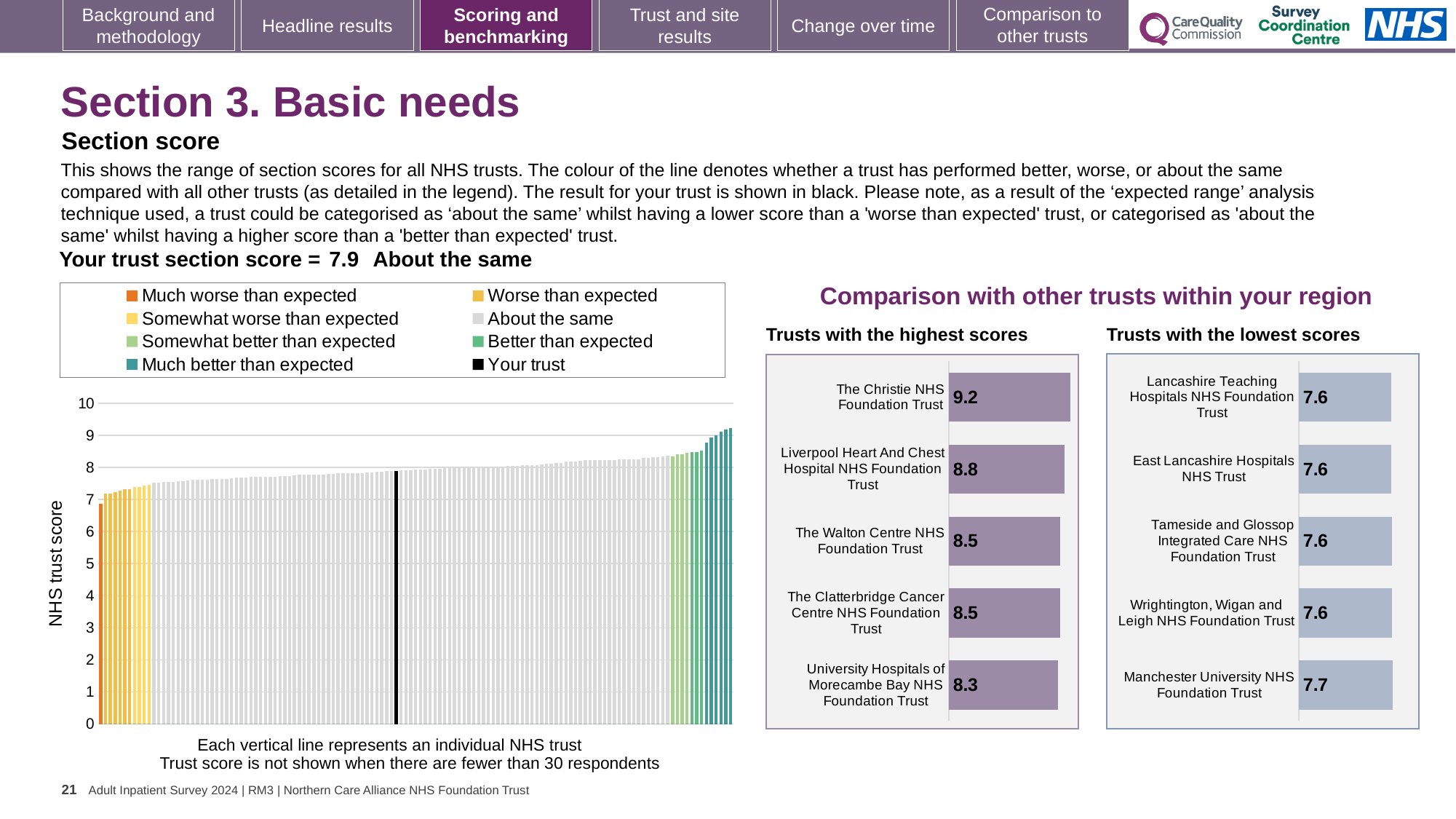
In the 'Trusts with the highest scores' chart, which trust has the lowest score shown? University Hospitals of Morecambe Bay NHS Foundation Trust How many trusts are listed in the 'Trusts with the highest scores' chart? 5 How many entries does the legend of the 'NHS trust score' chart on the left list? 8 In the 'NHS trust score' chart on the left, is the value of the tallest bar greater or less than 9? greater In the 'Trusts with the lowest scores' chart, what is the difference between the scores of Manchester University NHS Foundation Trust and East Lancashire Hospitals NHS Trust? 0.1 In the 'Trusts with the highest scores' chart, what is the difference between the scores of The Christie NHS Foundation Trust and Liverpool Heart And Chest Hospital NHS Foundation Trust? 0.4 In the 'Trusts with the lowest scores' chart, which trust has the highest score? Manchester University NHS Foundation Trust What kind of chart is the 'NHS trust score' chart on the left of the slide? Bar chart In the 'Trusts with the highest scores' chart, which has the higher score: Liverpool Heart And Chest Hospital NHS Foundation Trust or The Walton Centre NHS Foundation Trust? Liverpool Heart And Chest Hospital NHS Foundation Trust In the 'NHS trust score' chart on the left, do the values rise or fall from left to right? Rise In the 'Trusts with the lowest scores' chart, what is the score for Manchester University NHS Foundation Trust? 7.7 In the 'Trusts with the highest scores' chart, what is the score for The Christie NHS Foundation Trust? 9.2